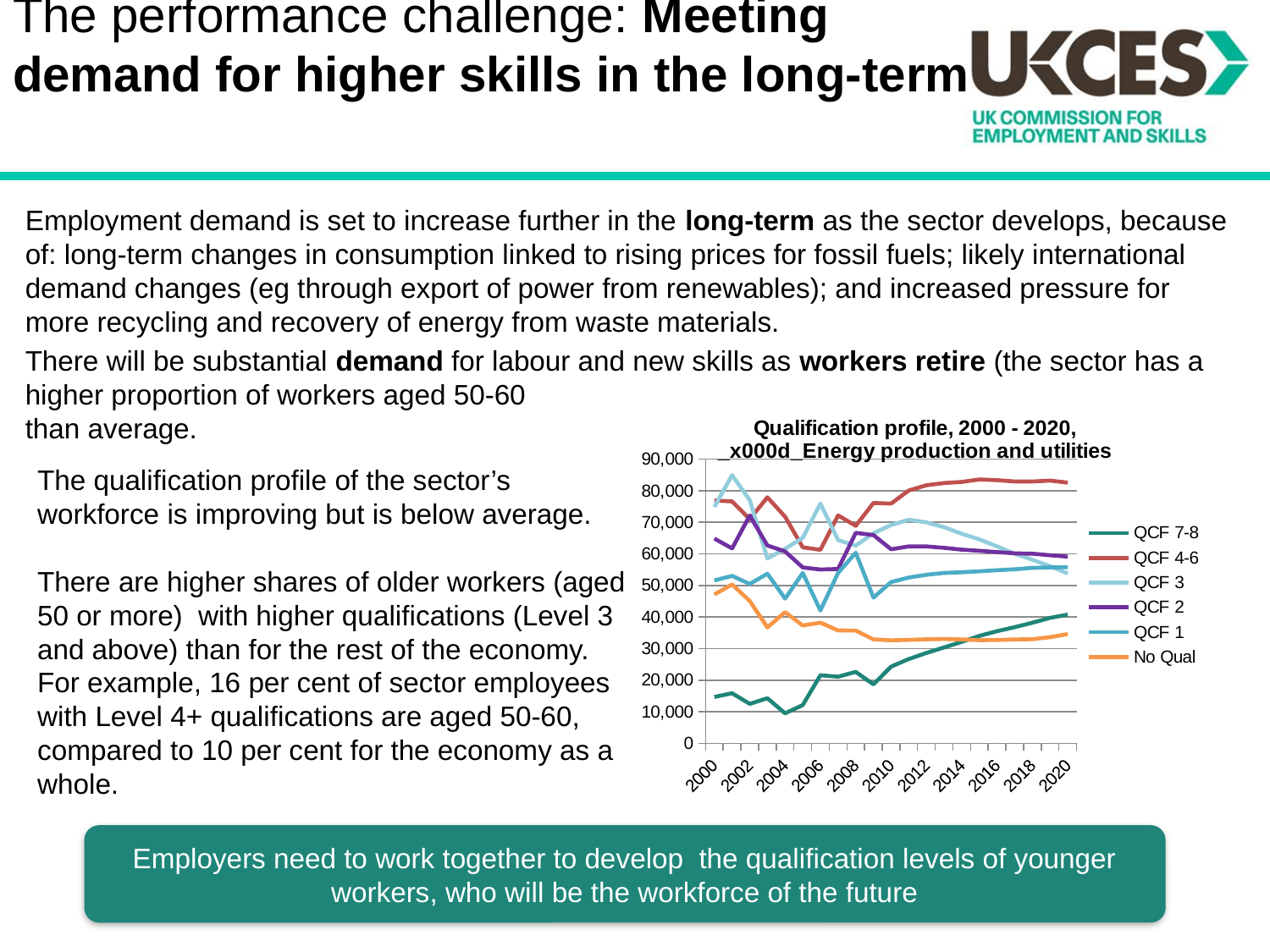
What kind of chart is shown on the slide? Line chart Is the value for No Qual in 2020 greater or less than 40,000? less Is the value for QCF 7-8 in 2000 greater or less than 10,000? greater Is the value for QCF 4-6 in 2020 greater or less than 80,000? greater What is the highest value shown on the y axis of the chart? 90,000 Which series has the lowest value in 2020? No Qual How many series does the legend of the chart list? 6 How many year labels are shown on the x axis of the chart? 11 Which series has the highest value in 2020? QCF 4-6 In 2020, which is larger: QCF 4-6 or QCF 2? QCF 4-6 Does the QCF 7-8 line rise or fall overall from 2000 to 2020? Rises Does the No Qual line rise or fall overall from 2000 to 2020? Falls